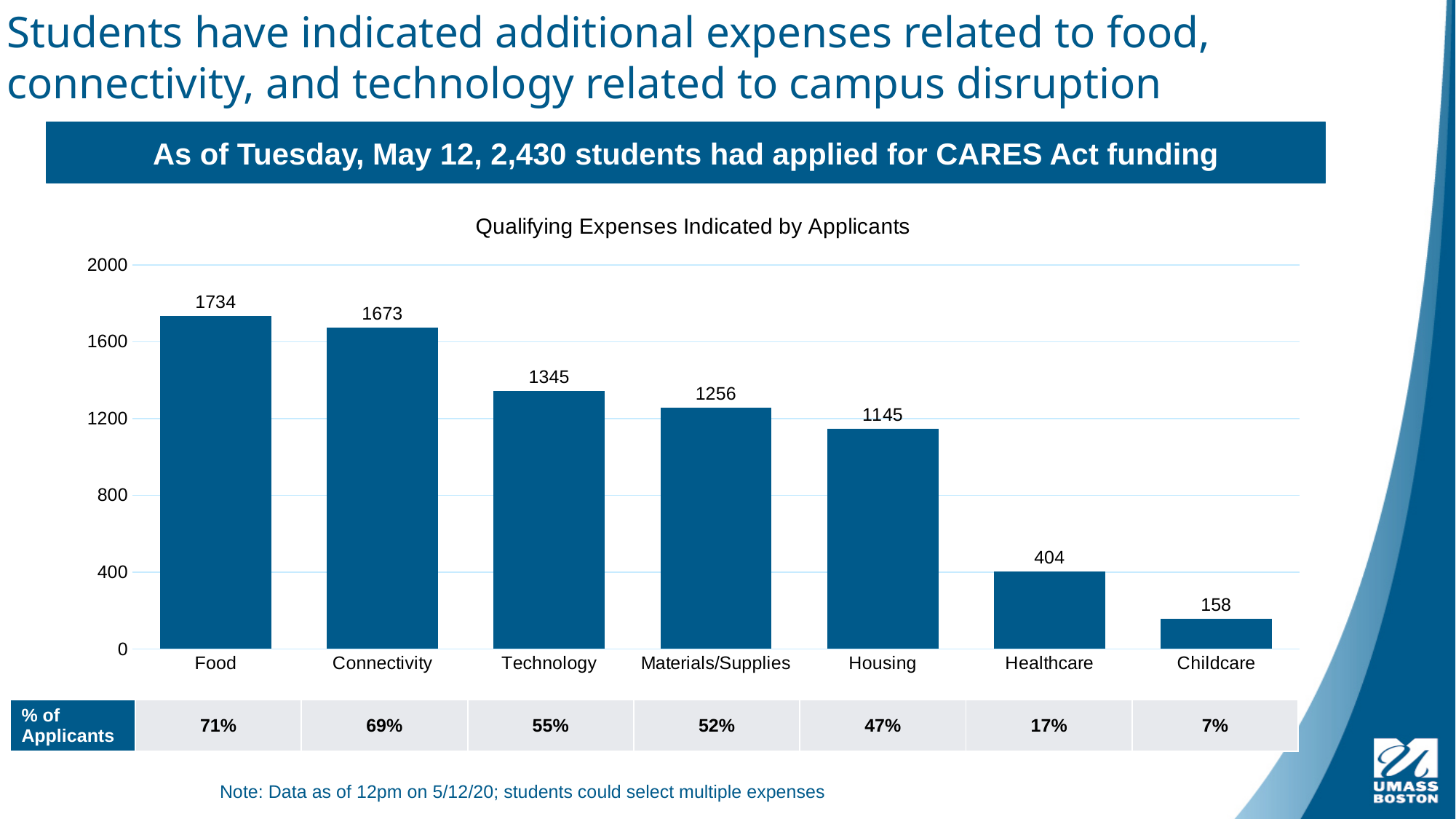
Which category has the lowest value? Childcare How many categories are shown in the chart? 7 What is the value for Housing? 1145 What is the title of the chart? Qualifying Expenses Indicated by Applicants Which category has the highest value? Food What kind of chart is shown on the slide? Bar chart Is the value for Healthcare greater or less than 400? greater Which is larger, the value for Materials/Supplies or the value for Housing? Materials/Supplies What is the value for Food in the Qualifying Expenses Indicated by Applicants chart? 1734 What is the difference between the values for Technology and Healthcare? 941 What is the difference between the values for Food and Connectivity? 61 What is the value for Childcare? 158